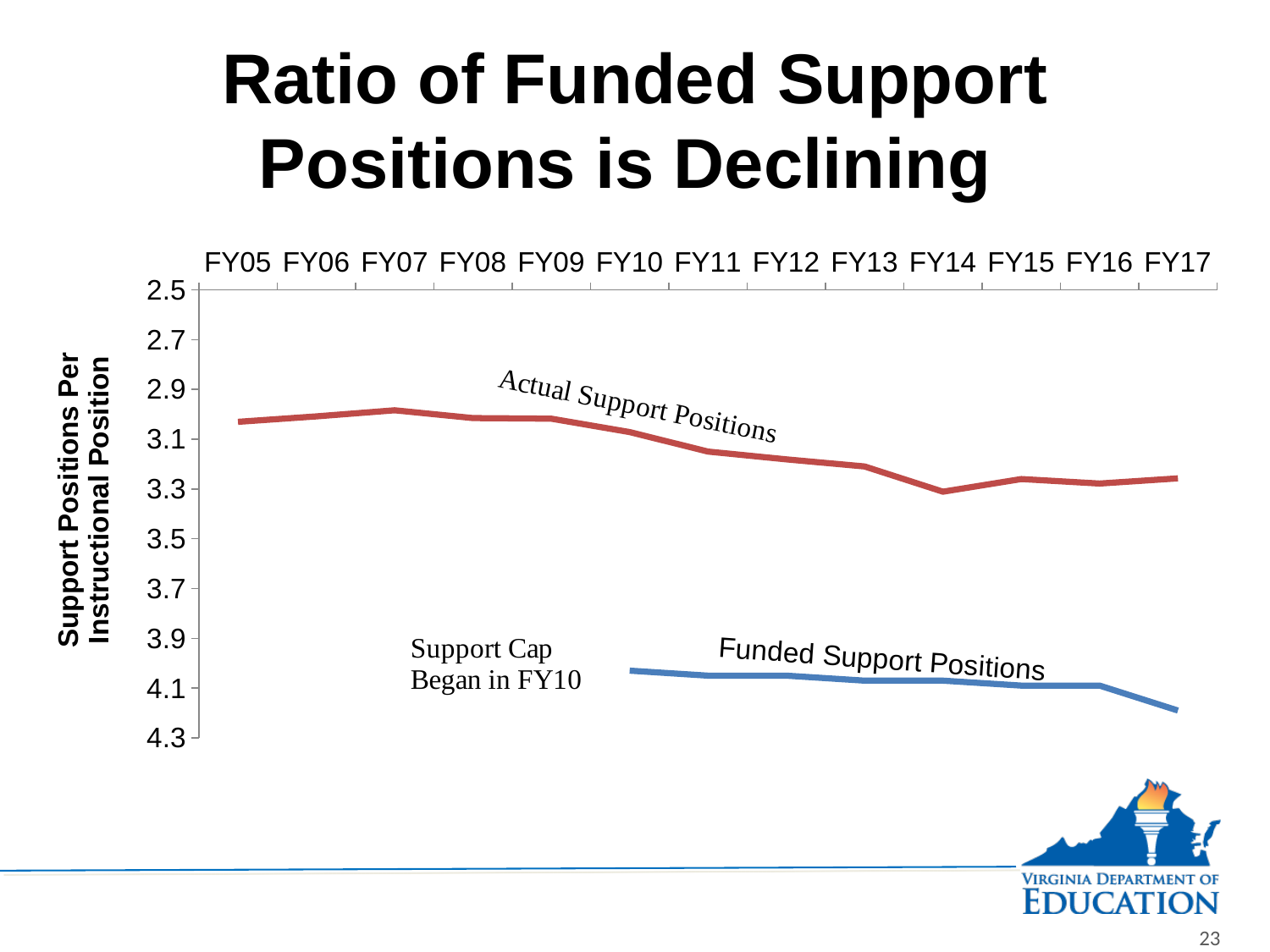
In FY10, which series has the larger value: Actual Support Positions or Funded Support Positions? Funded Support Positions Is the Funded Support Positions value for FY10 greater or less than 3.9? greater What type of chart is shown on the slide? line chart How many fiscal years are shown along the x axis? 13 How many data series are plotted on the chart? 2 Is the Actual Support Positions value for FY05 greater or less than 3.1? less Is the Actual Support Positions value for FY05 greater or less than 2.9? greater In which fiscal year does the Funded Support Positions line reach its highest value? FY17 What is the first fiscal year shown on the x axis? FY05 In which fiscal year does the Funded Support Positions line begin? FY10